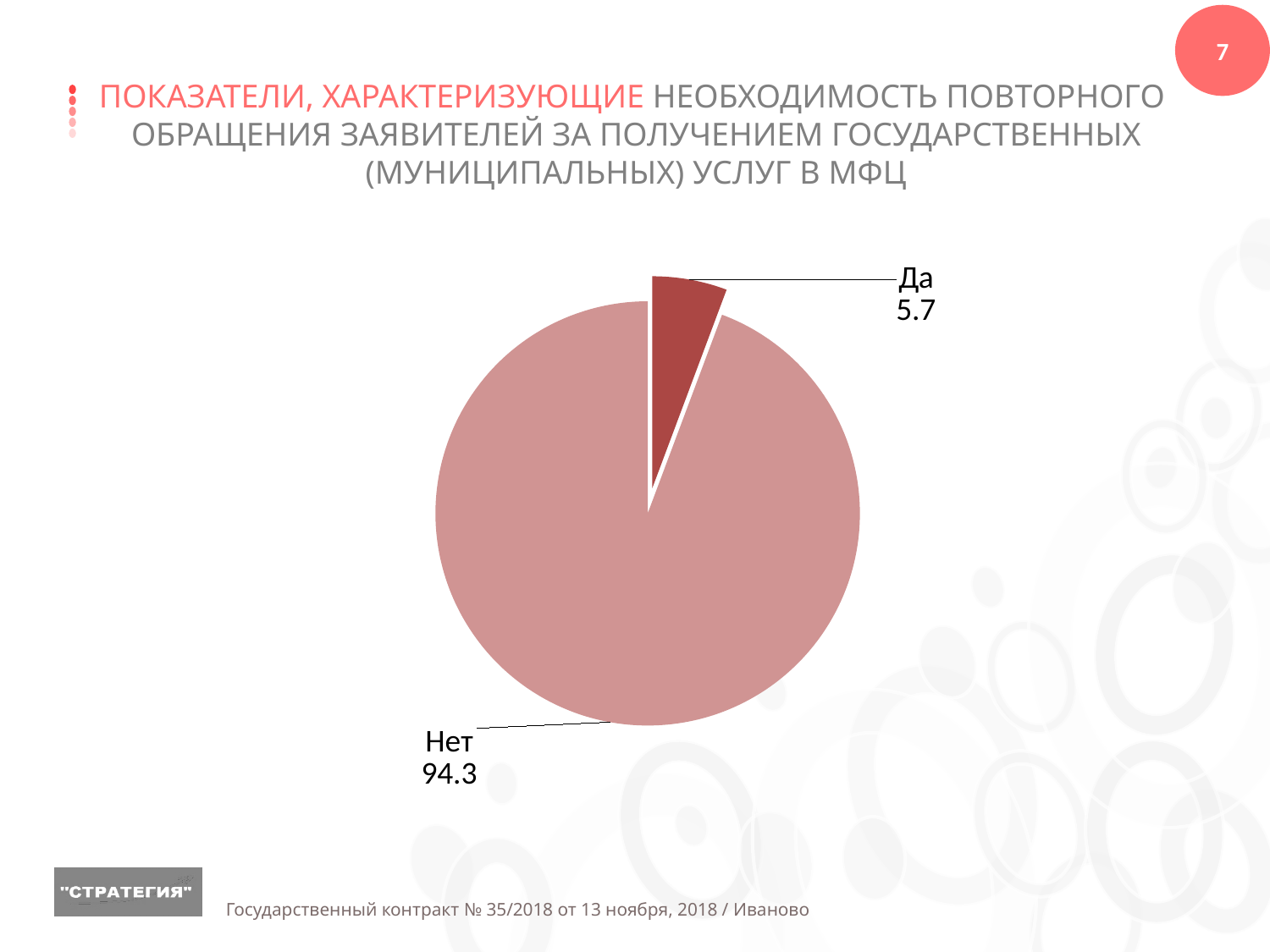
Which slice is the largest? Нет Which is larger, the value for "Да" or the value for "Нет"? Нет What is the difference between the values for "Нет" and "Да"? 88.6 What is the value for the "Да" slice? 5.7 Which slice is pulled out (exploded) from the pie? Да Which slice is the smallest? Да What type of chart is shown on the slide? pie chart Which slice is drawn in the darker red colour? Да What is the value for the "Нет" slice? 94.3 How many slices does the pie chart have? 2 What is the total of the two slice values? 100